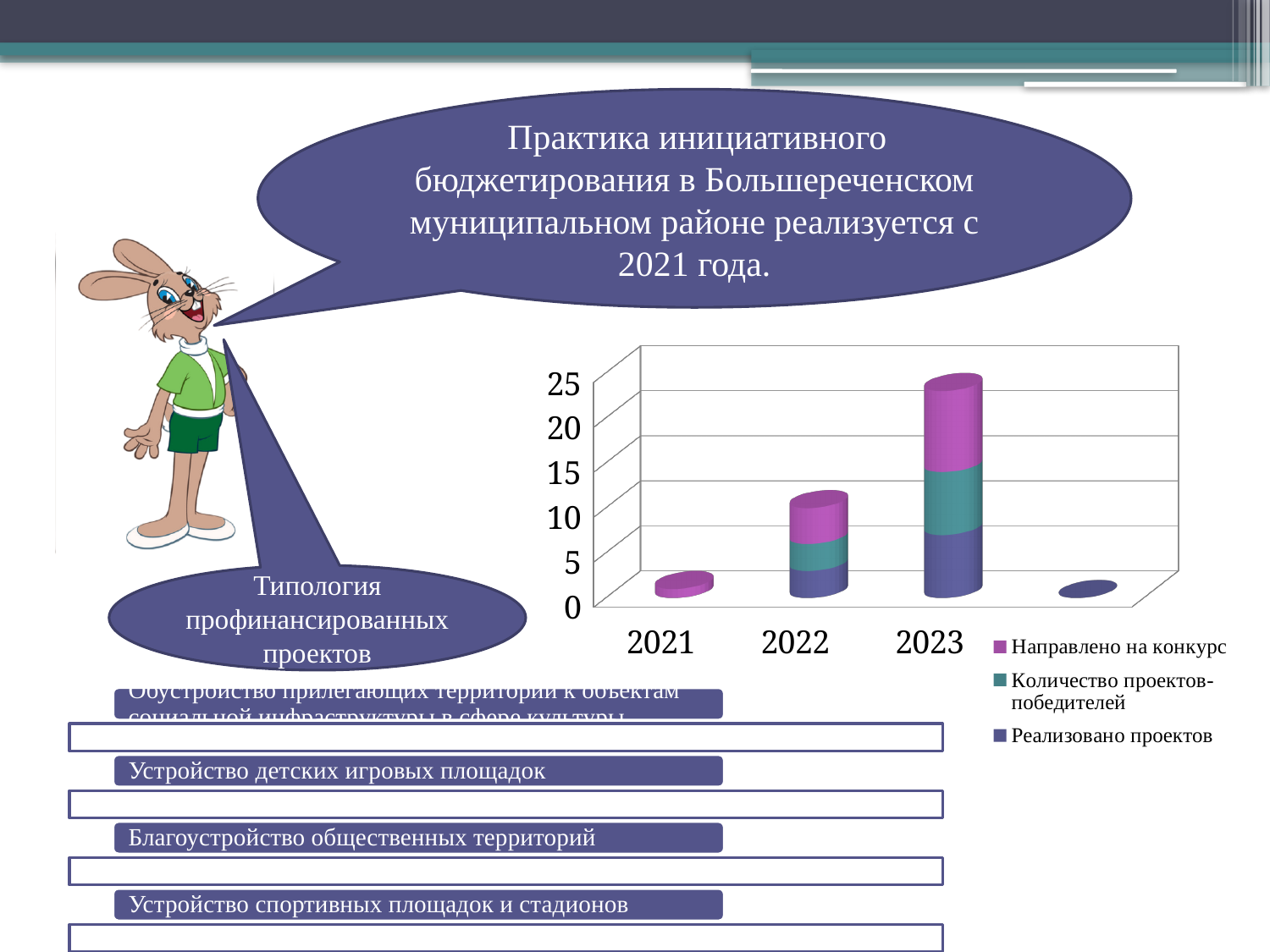
Is the total height of the stacked bar for 2022 greater or less than 5? greater Which year has a taller stacked bar, 2022 or 2023? 2023 Is the total height of the stacked bar for 2022 greater or less than 15? less Is the total height of the stacked bar for 2021 greater or less than 5? less Which series is shown in dark blue in the chart legend? Реализовано проектов Do the stacked bar totals rise or fall from 2021 to 2023? rise Which year has the tallest stacked bar in the chart? 2023 Which series is shown in pink/magenta in the chart legend? Направлено на конкурс Which of the labeled years has the shortest stacked bar in the chart? 2021 How many series does the chart legend list? 3 What kind of chart is shown on the slide? stacked bar chart